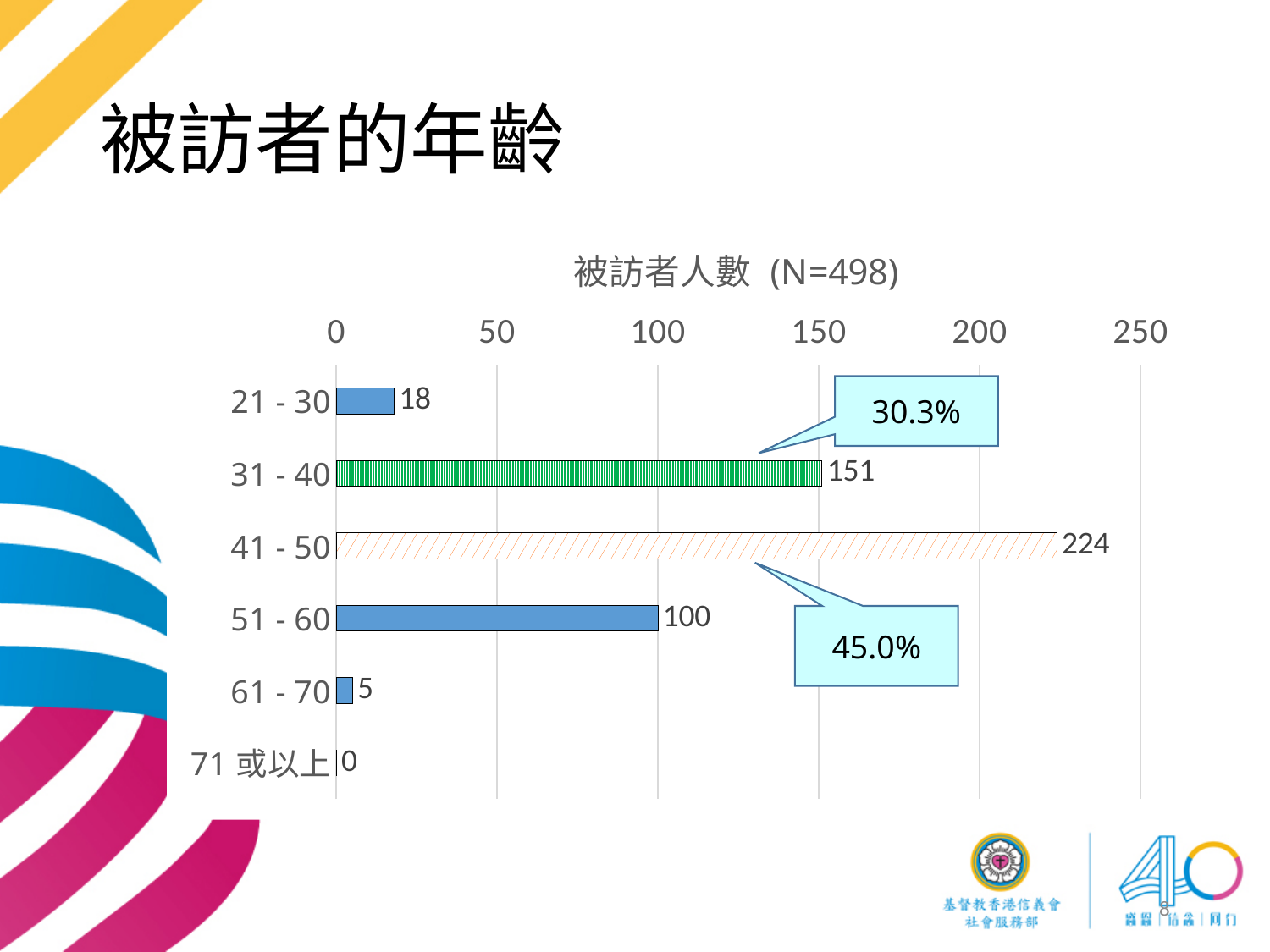
How many age groups are shown on the chart? 6 Is the value for 31 - 40 greater or less than 100? greater Which age group has the lowest number of respondents? 71 或以上 What is the difference between the values for 41 - 50 and 31 - 40? 73 Which age group has the highest number of respondents? 41 - 50 What kind of chart is shown on the slide? bar chart What is the value for the 51 - 60 age group? 100 What is the value for the 41 - 50 age group? 224 Which is larger, the value for 51 - 60 or the value for 21 - 30? 51 - 60 What is the value for the 31 - 40 age group? 151 What percentage does the callout attached to the 41 - 50 bar show? 45.0% What is the value for the 61 - 70 age group? 5